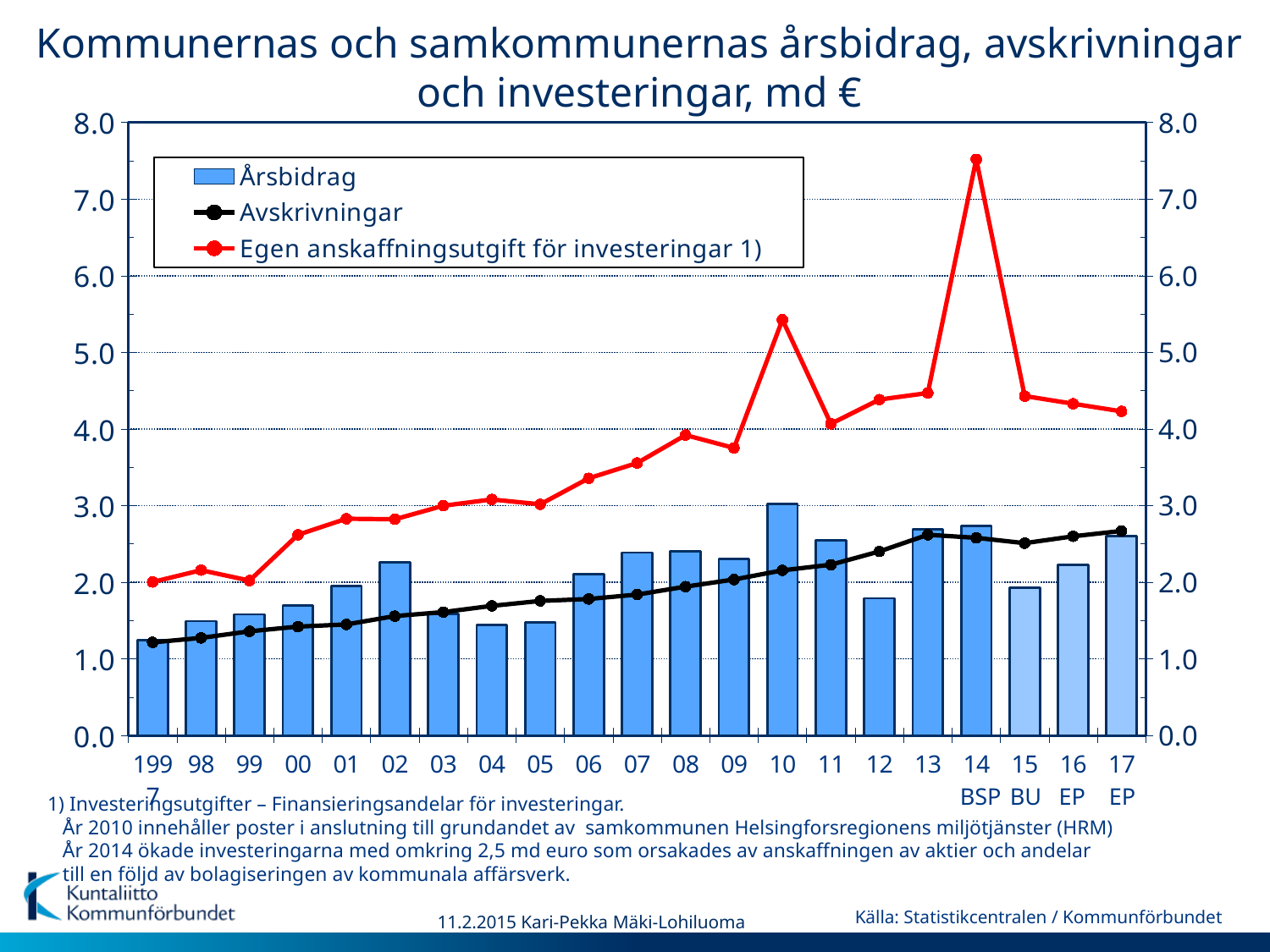
Is the value of Egen anskaffningsutgift för investeringar in 10 greater or less than 5.0? greater How many years are shown on the x axis? 21 In which year does the Egen anskaffningsutgift för investeringar line reach its highest value? 14 In which year is the Årsbidrag bar the tallest? 10 What kind of chart is shown on the slide? A combined bar and line chart How many series does the legend list? 3 Is the Avskrivningar value in 17 greater or less than 2.5? greater Which is larger, the Årsbidrag bar for 10 or for 11? 10 Does the Avskrivningar line generally rise or fall from 1997 to 17? rise In which year is the Årsbidrag bar the lowest? 1997 Is the value of Egen anskaffningsutgift för investeringar in 14 greater or less than 7.0? greater